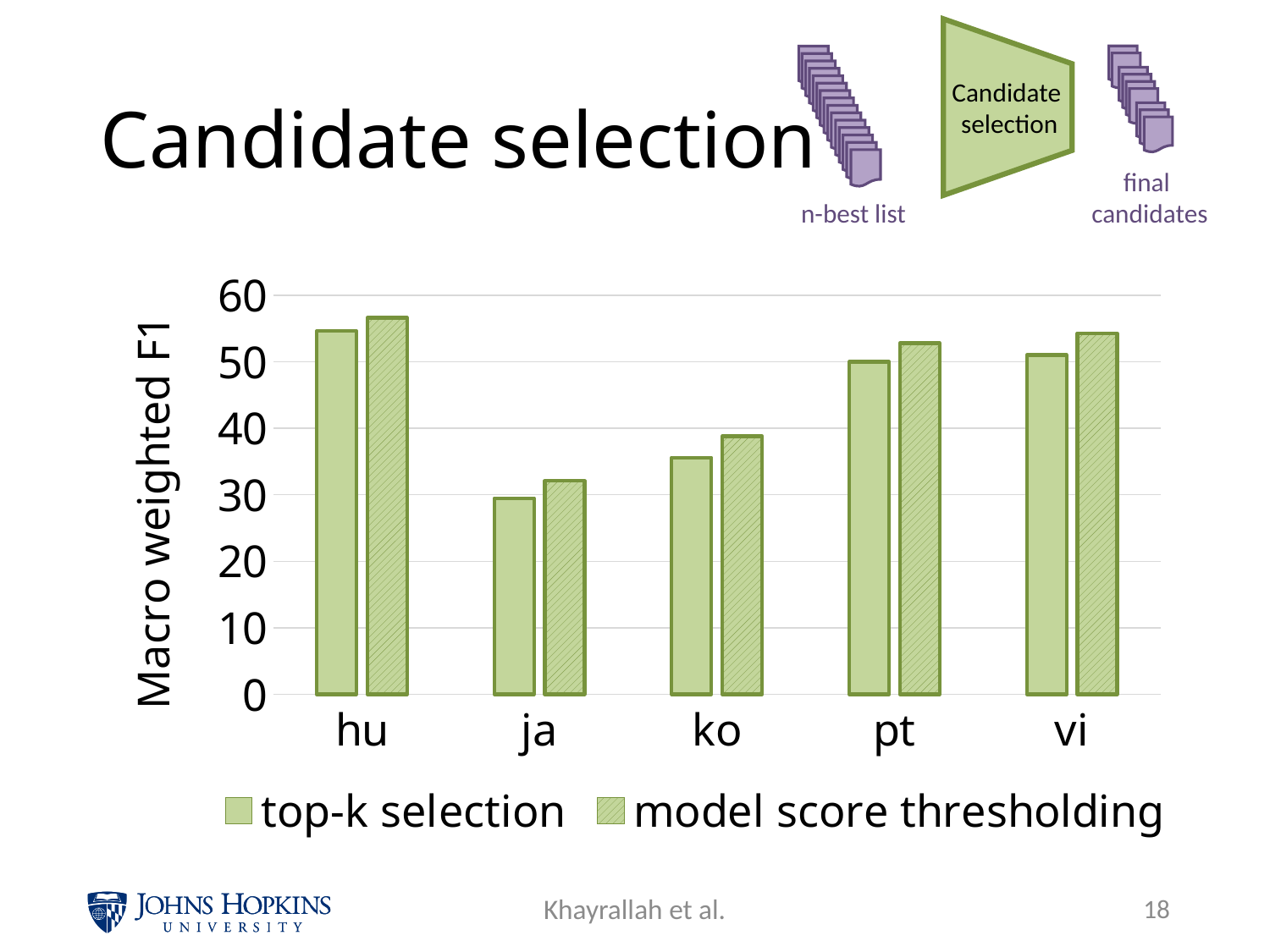
For ja, which is larger: top-k selection or model score thresholding? model score thresholding Is the top-k selection value for ko greater or less than 30? greater What kind of chart is shown on the slide? bar chart How many language categories are shown on the x axis? 5 Which language has the lowest model score thresholding value? ja What is the label of the y axis? Macro weighted F1 Which is larger: the top-k selection value for hu or for pt? hu Is the model score thresholding value for ko greater or less than 40? less Which language has the lowest top-k selection value? ja Is the model score thresholding value for hu greater or less than 50? greater How many series does the legend list? 2 Which language has the highest top-k selection value? hu